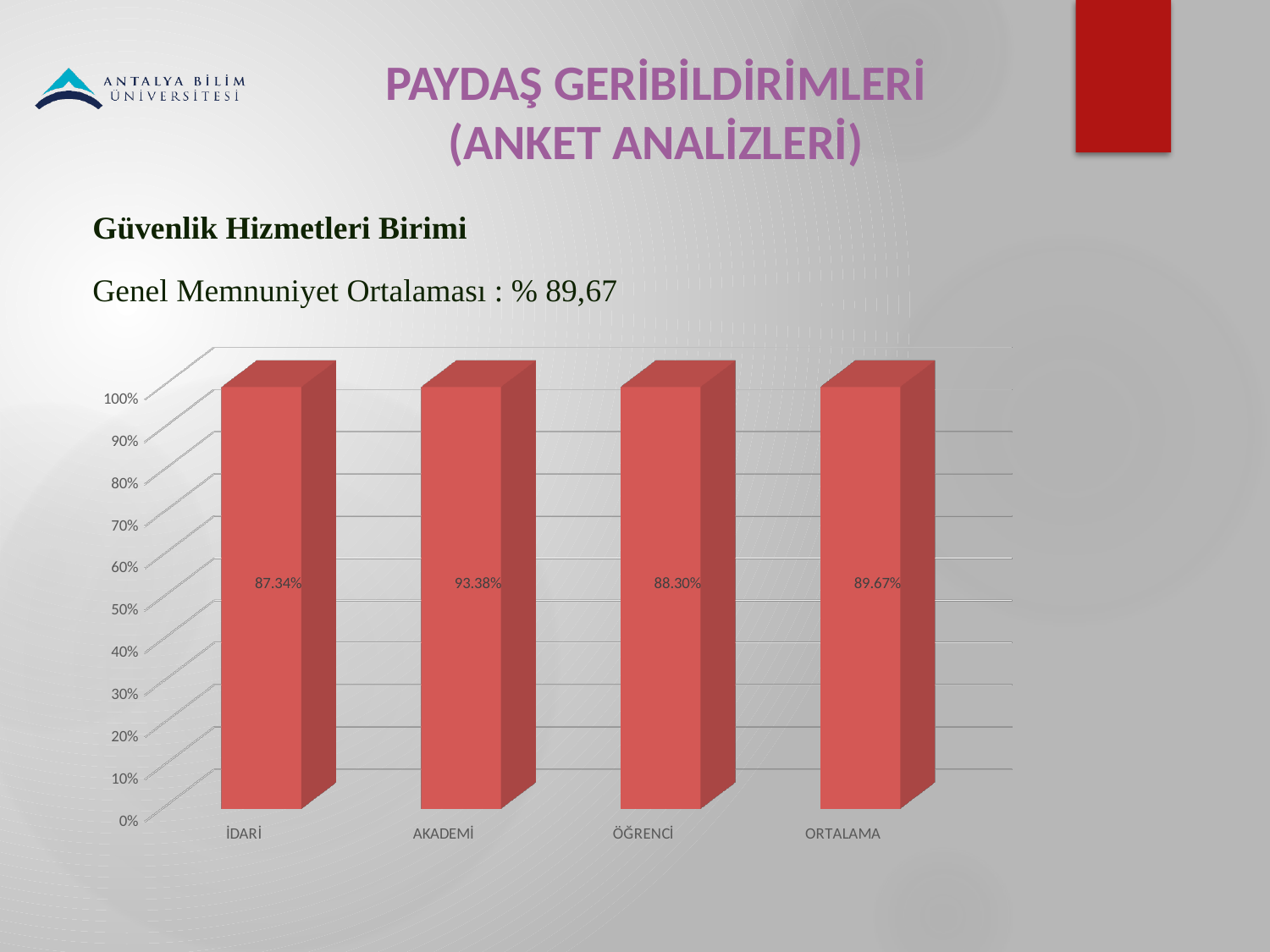
What is the value for AKADEMİ? 93.38% What is the value for ORTALAMA? 89.67% What is the value for İDARİ? 87.34% Which is larger, the value for AKADEMİ or the value for ÖĞRENCİ? AKADEMİ What kind of chart is shown on the slide? Bar chart What is the difference between the values for AKADEMİ and ÖĞRENCİ? 5.08% What colour are the bars in the chart? Red Which category has the lowest value? İDARİ How many categories are shown on the x axis? 4 What is the value for ÖĞRENCİ? 88.30% Which category has the highest value? AKADEMİ What is the difference between the values for AKADEMİ and İDARİ? 6.04%